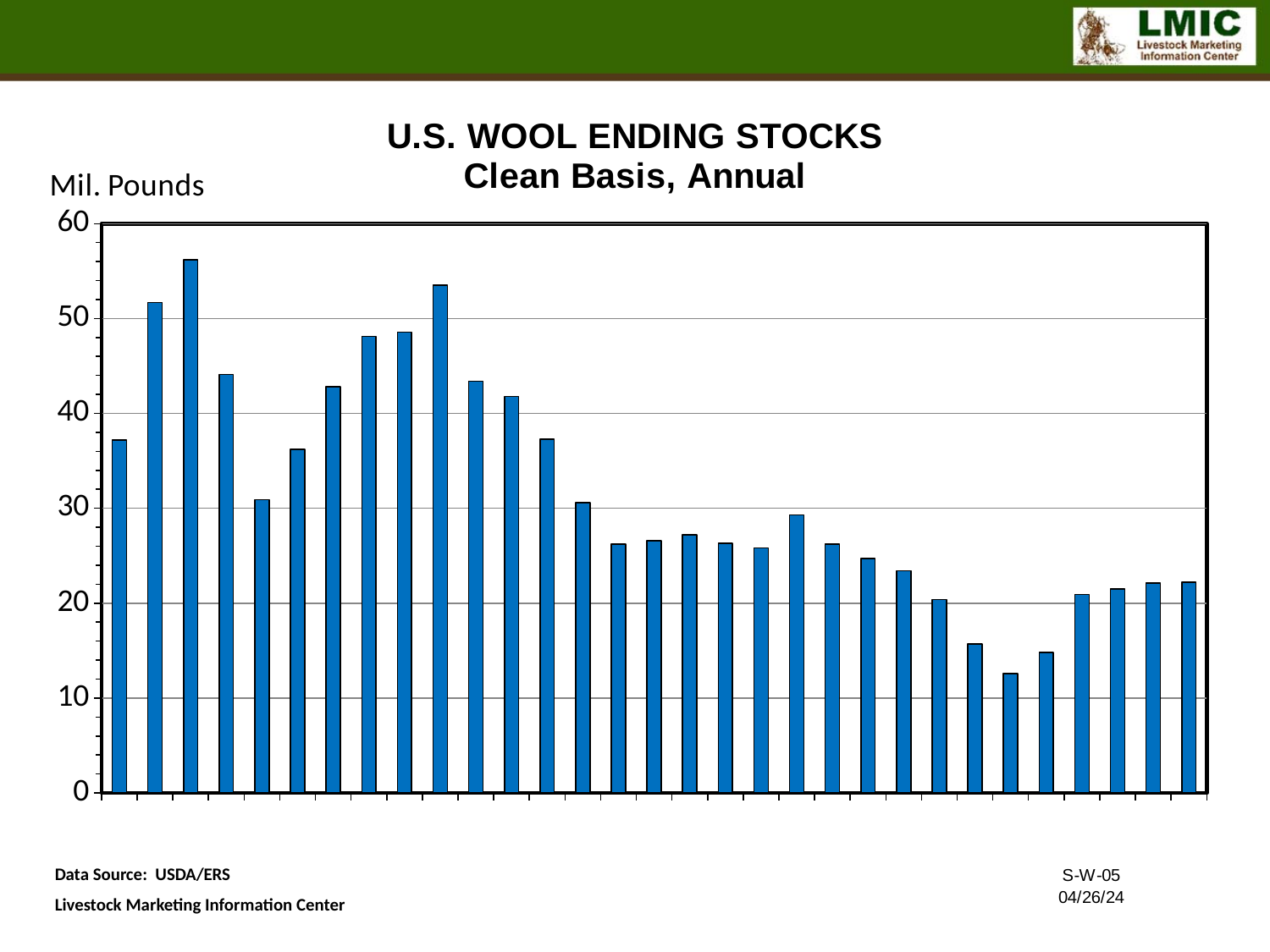
Is the value of the first (leftmost) bar greater or less than 40? less What is the title of the chart? U.S. WOOL ENDING STOCKS Clean Basis, Annual Is the value of the last (rightmost) bar greater or less than 20? greater Overall, do the values rise or fall moving from left to right across the chart? fall How many bars are plotted in the chart? 31 Which is larger, the value of the first (leftmost) bar or the value of the last (rightmost) bar? the first (leftmost) bar Is the value of the shortest bar greater or less than 20? less What unit is shown on the vertical axis of the chart? Mil. Pounds What kind of chart is shown on the slide? bar chart